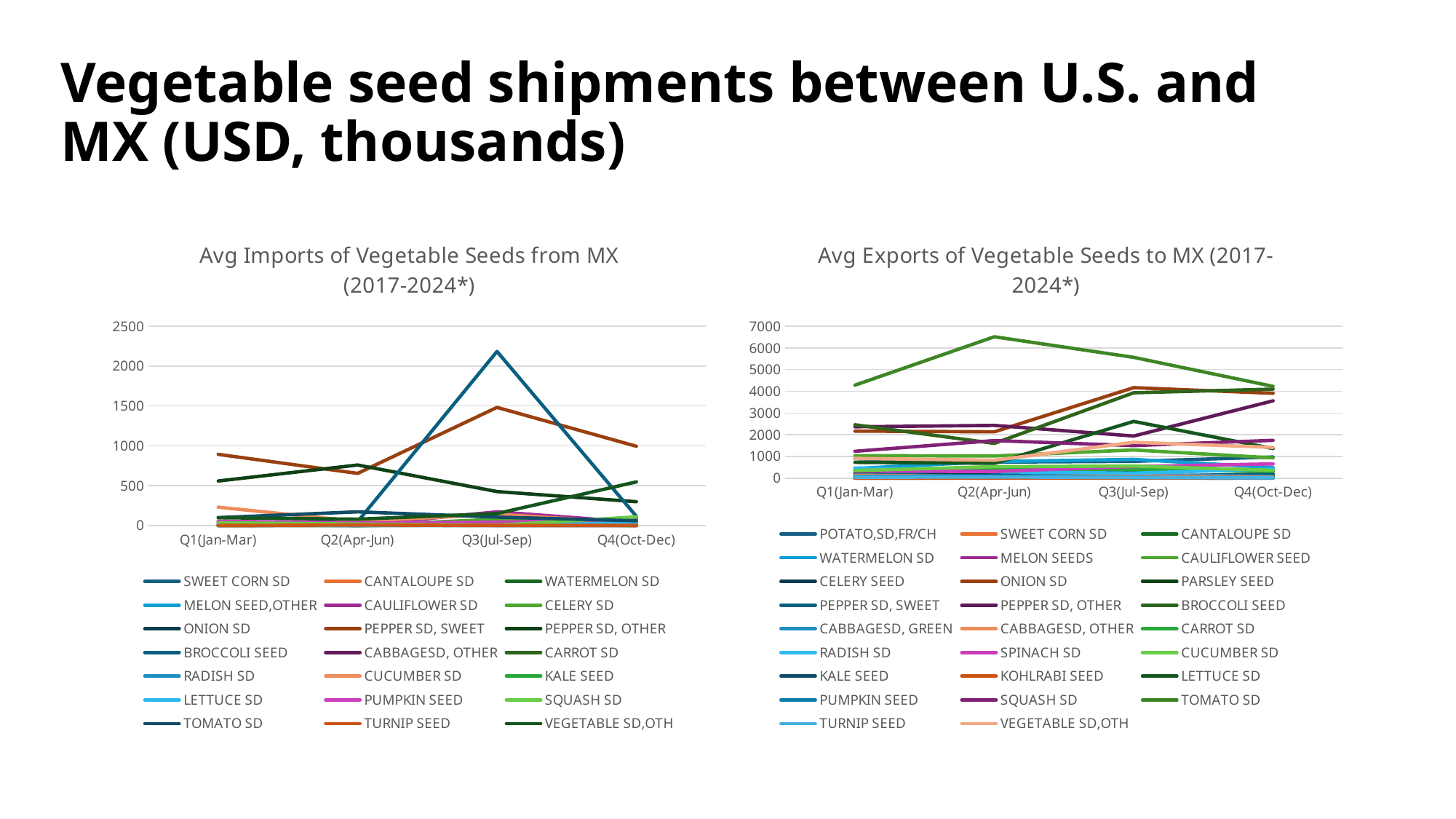
What kind of chart is the 'Avg Imports of Vegetable Seeds from MX (2017-2024*)' chart? line chart In the 'Avg Imports of Vegetable Seeds from MX' chart, in which quarter does the highest peak of any series occur? Q3(Jul-Sep) In the 'Avg Imports of Vegetable Seeds from MX' chart, is the highest plotted value greater or less than 2000? greater What kind of chart is the 'Avg Exports of Vegetable Seeds to MX (2017-2024*)' chart? line chart In the 'Avg Exports of Vegetable Seeds to MX' chart, in which quarter does the highest peak of any series occur? Q2(Apr-Jun) What is the title of the left chart on the slide? Avg Imports of Vegetable Seeds from MX (2017-2024*) In the 'Avg Exports of Vegetable Seeds to MX' chart, is the highest plotted value greater or less than 6000? greater How many series does the legend of the 'Avg Imports of Vegetable Seeds from MX' chart list? 21 What is the highest value shown on the y axis of the 'Avg Exports of Vegetable Seeds to MX' chart? 7000 In the 'Avg Imports of Vegetable Seeds from MX' chart, how many quarters are shown on the x axis? 4 How many series does the legend of the 'Avg Exports of Vegetable Seeds to MX' chart list? 26